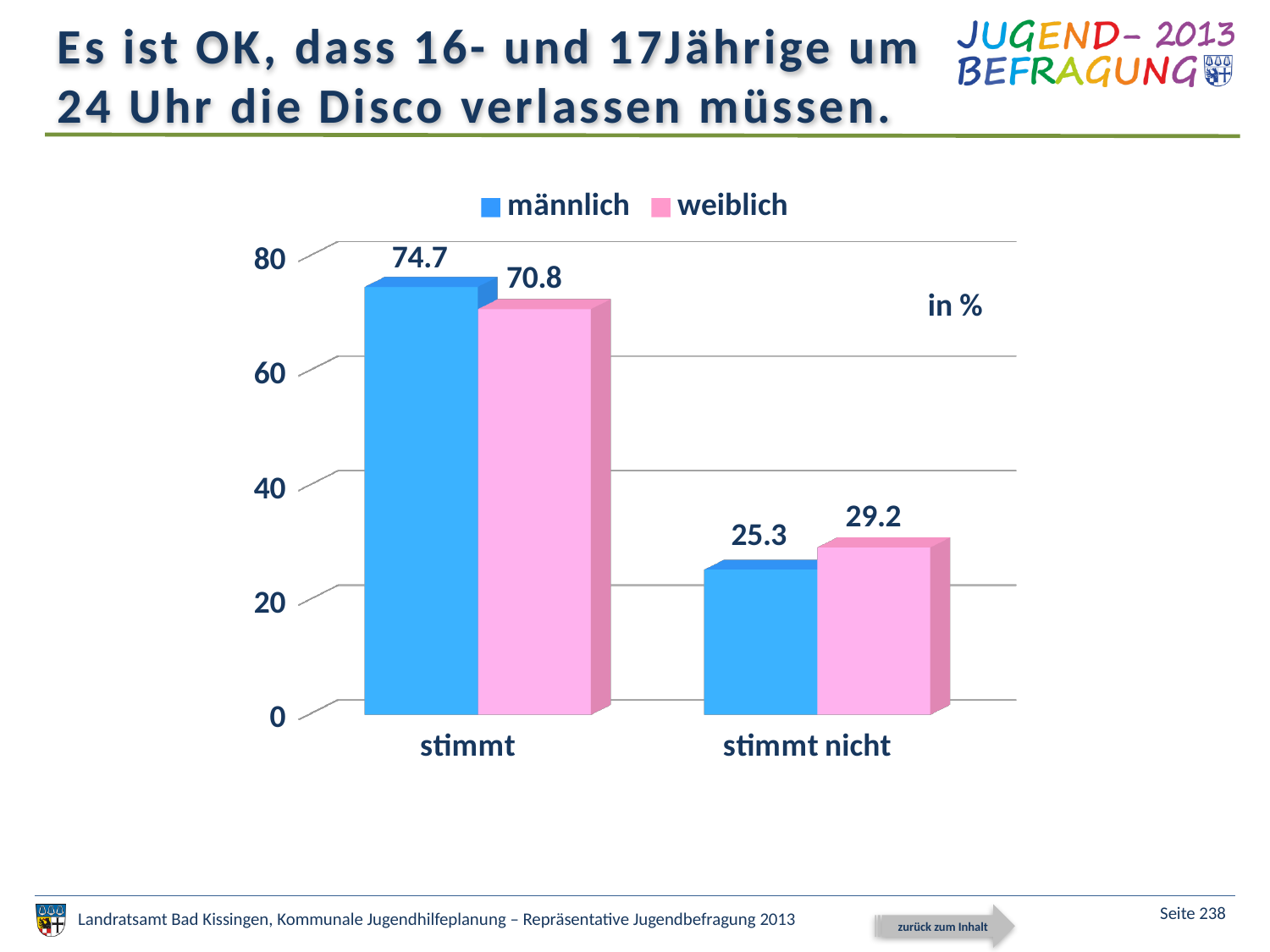
What is the difference between the männlich and weiblich values in the stimmt category? 3.9 Which category has the highest value for männlich? stimmt What is the value for weiblich in the stimmt category? 70.8 What is the value for männlich in the stimmt nicht category? 25.3 What kind of chart is shown on the slide? bar chart In the stimmt nicht category, which is larger: männlich or weiblich? weiblich Is the value for weiblich in the stimmt category greater or less than 60? greater What is the value for weiblich in the stimmt nicht category? 29.2 How many series does the legend list? 2 What is the value for männlich in the stimmt category? 74.7 How many categories are shown on the x axis? 2 Which category has the lowest value for weiblich? stimmt nicht